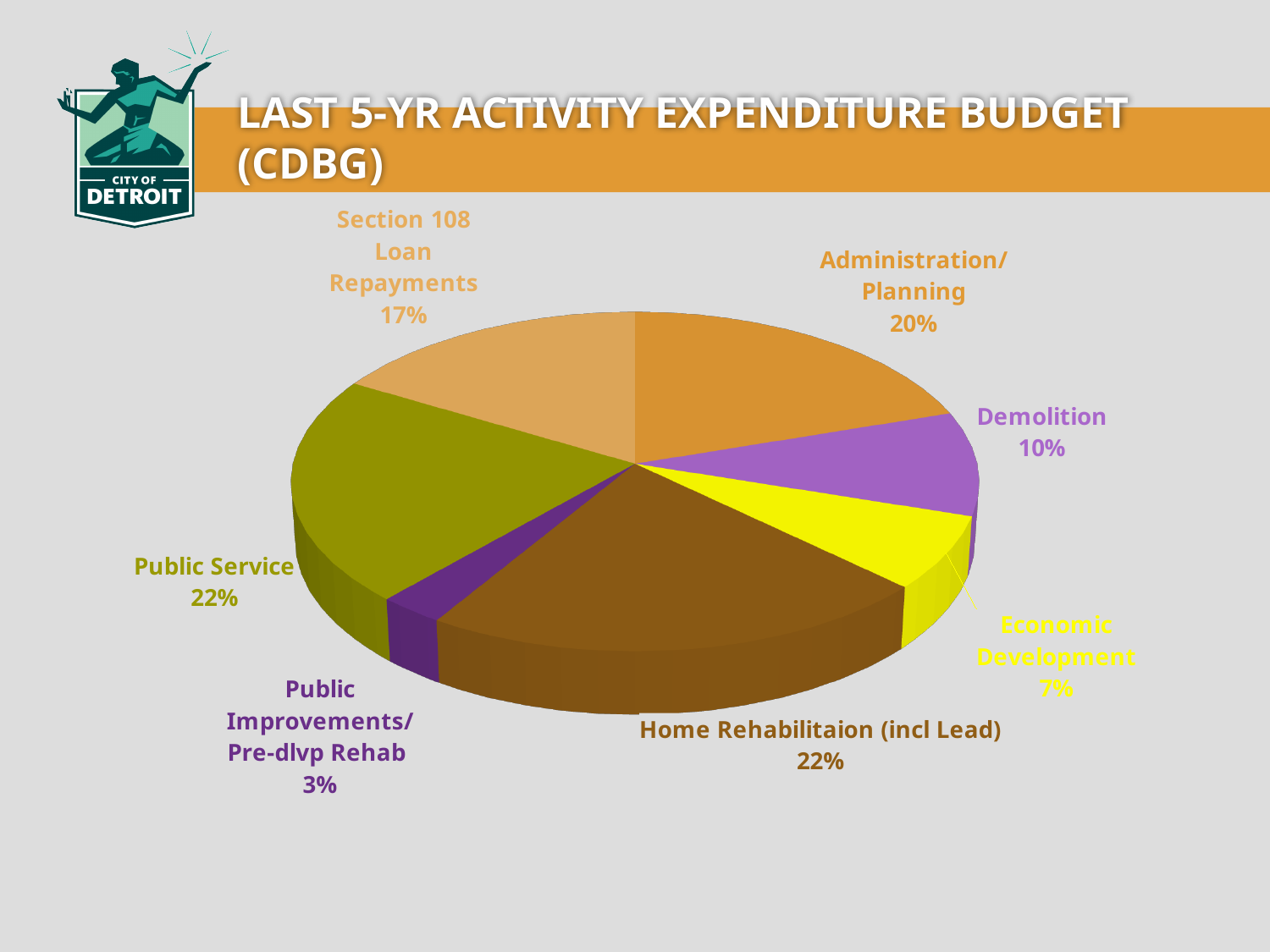
What kind of chart is shown on the slide? Pie chart What percentage is shown for Economic Development? 7% What is the difference in percentage points between Administration/Planning and Section 108 Loan Repayments? 3 What share of the pie does Administration/Planning represent? 20% What percentage is shown for Public Improvements/Pre-dlvp Rehab? 3% What is the difference in percentage points between Public Service and Demolition? 12 What is the title of the chart on the slide? LAST 5-YR ACTIVITY EXPENDITURE BUDGET (CDBG) Which category has the smallest share of the pie? Public Improvements/Pre-dlvp Rehab How many categories are shown in the pie chart? 7 What percentage is shown for Section 108 Loan Repayments? 17% What percentage is shown for Demolition? 10% Which is larger, the share for Demolition or the share for Economic Development? Demolition